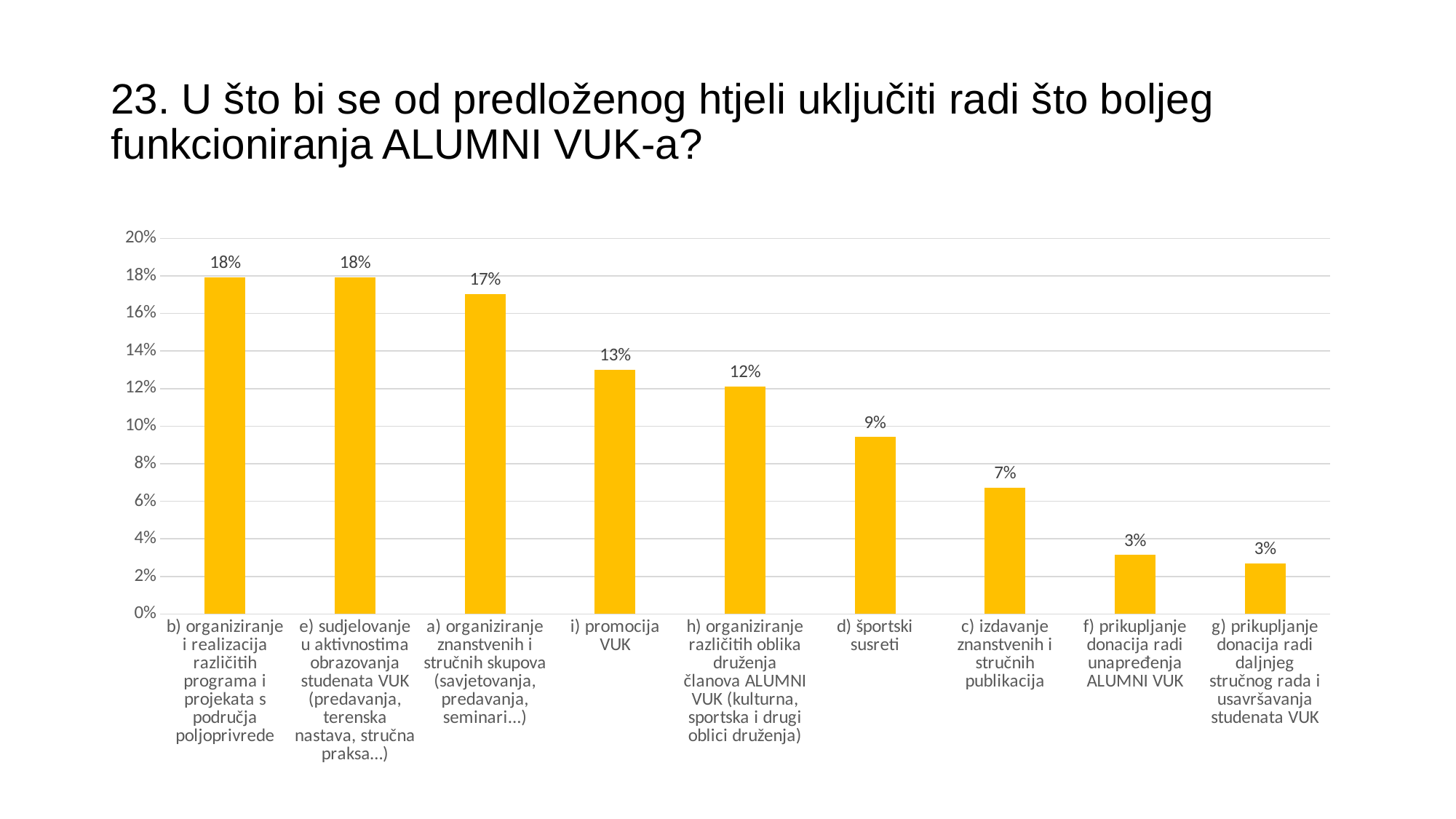
What is the value for "a) organiziranje znanstvenih i stručnih skupova (savjetovanja, predavanja, seminari…)"? 17% What is the value for "c) izdavanje znanstvenih i stručnih publikacija"? 7% What is the value for "h) organiziranje različitih oblika druženja članova ALUMNI VUK (kulturna, sportska i drugi oblici druženja)"? 12% How many categories are shown on the x axis? 9 What is the difference between the value for "i) promocija VUK" and the value for "d) športski susreti"? 4% Which is larger: the value for "h) organiziranje različitih oblika druženja članova ALUMNI VUK" or the value for "d) športski susreti"? h) organiziranje različitih oblika druženja članova ALUMNI VUK What is the value for "d) športski susreti"? 9% Do the values rise or fall from left to right along the x axis? fall What is the difference between the value for "a) organiziranje znanstvenih i stručnih skupova" and the value for "c) izdavanje znanstvenih i stručnih publikacija"? 10% What is the value for "i) promocija VUK"? 13% What kind of chart is shown on the slide? bar chart Is the value for "i) promocija VUK" greater or less than 10%? greater